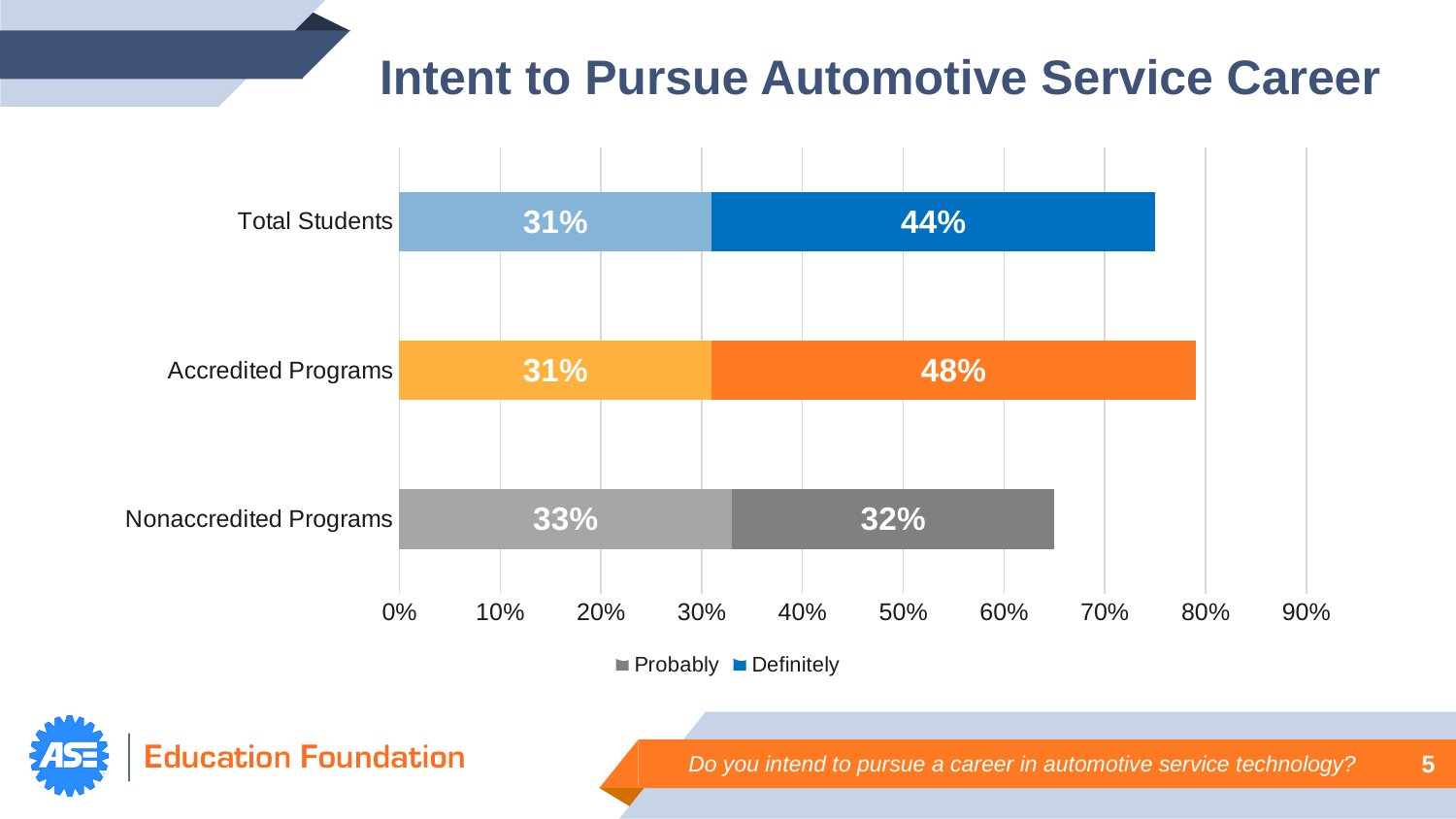
Which category has the highest 'Definitely' value? Accredited Programs What kind of chart is shown on the slide? Stacked bar chart What is the combined total of 'Probably' and 'Definitely' for Nonaccredited Programs? 65% What is the combined total of 'Probably' and 'Definitely' for Accredited Programs? 79% What is the 'Probably' value for Nonaccredited Programs? 33% Which is larger: the 'Probably' value for Nonaccredited Programs or the 'Probably' value for Total Students? Nonaccredited Programs What is the 'Definitely' value for Accredited Programs? 48% What is the 'Definitely' value for Total Students? 44% Which category has the lowest 'Definitely' value? Nonaccredited Programs How many categories are shown on the chart? 3 What is the difference between the 'Definitely' values for Accredited Programs and Nonaccredited Programs? 16% How many series does the legend list? 2